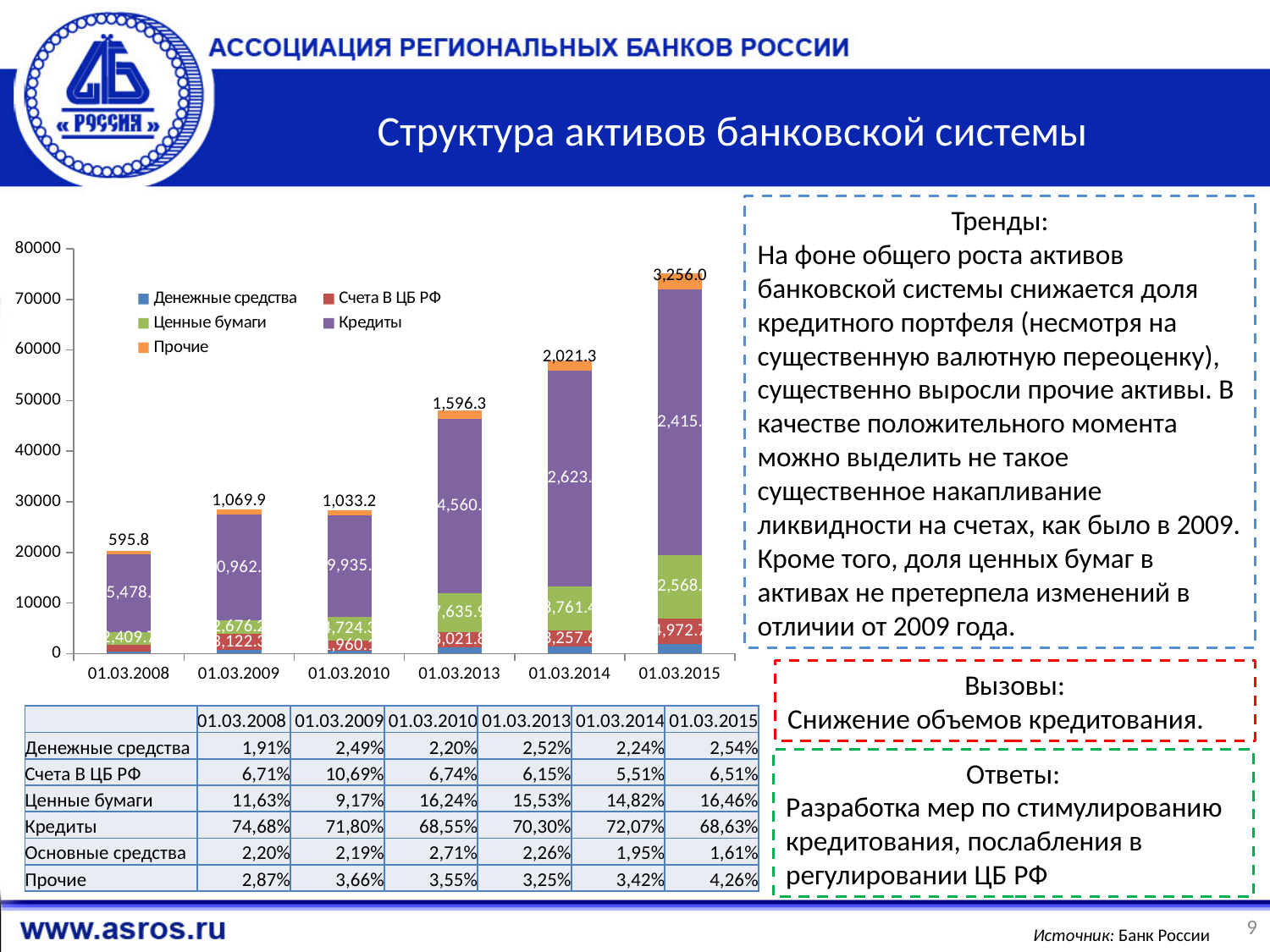
Is the total height of the stacked bar for 01.03.2008 greater or less than 30000? less Which date has the lowest value labelled above its bar? 01.03.2008 Is the total height of the stacked bar for 01.03.2015 greater or less than 70000? greater Which date has the highest value labelled above its bar? 01.03.2015 What is the value labelled above the bar for 01.03.2008? 595.8 How many series does the chart legend list? 5 Which has the larger value labelled above its bar, 01.03.2009 or 01.03.2010? 01.03.2009 How many dates (categories) are shown on the x axis of the chart? 6 What kind of chart is shown on the slide? stacked bar chart What is the value labelled above the bar for 01.03.2013? 1,596.3 What is the value labelled above the bar for 01.03.2015 (the Прочие label)? 3,256.0 What is the difference between the values labelled above the bars for 01.03.2015 and 01.03.2014? 1,234.7